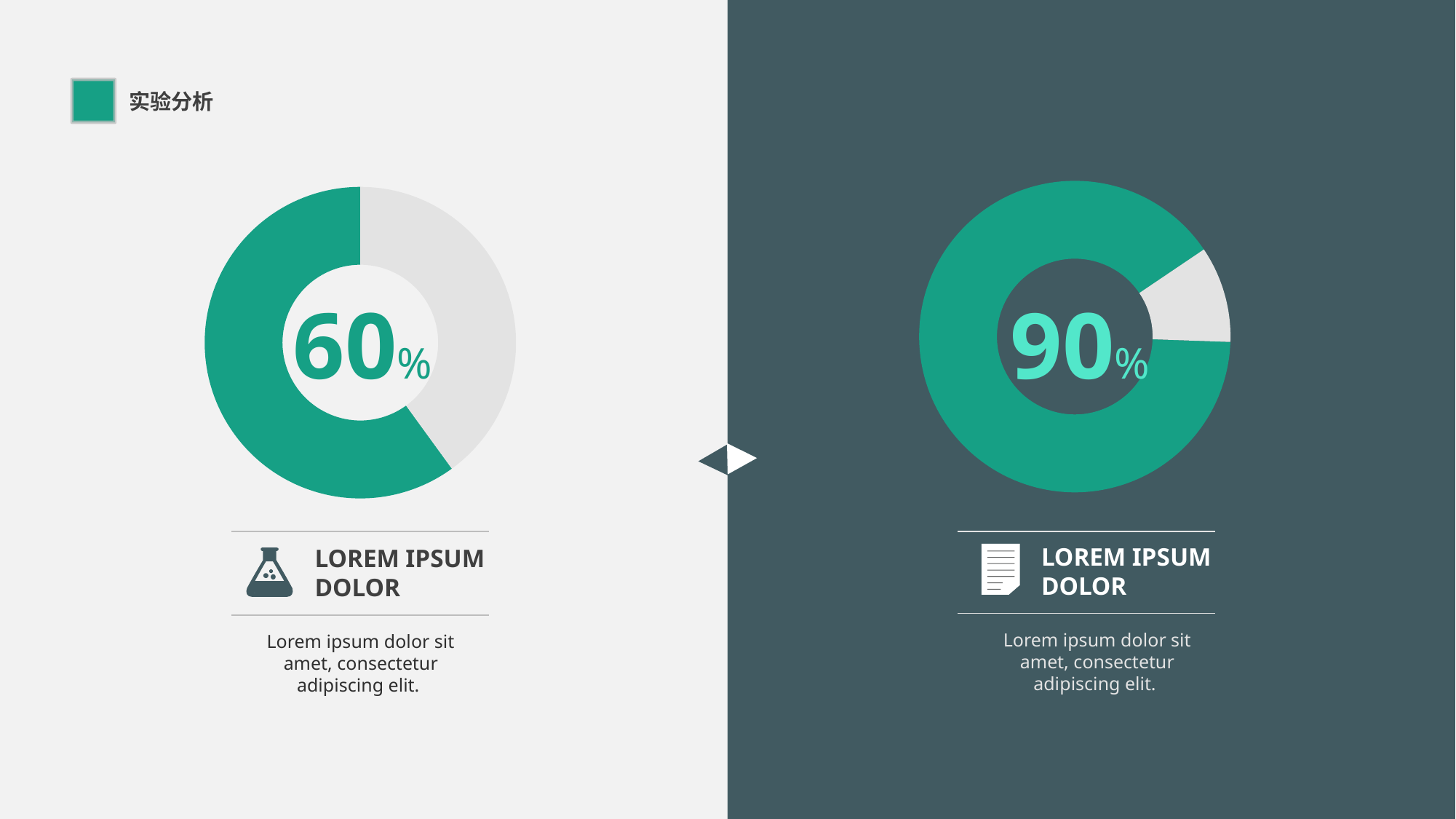
Is the value shown on the left donut chart greater or less than 50%? greater What percentage is shown in the centre of the right donut chart? 90% How many donut charts are on the slide? 2 On the left donut chart, what share of the ring is not filled in green? 40% What is the difference between the percentage on the right chart and the percentage on the left chart? 30% What kind of chart is used on the left side of the slide? donut chart Which chart shows the larger percentage, the left one or the right one? the right one What percentage is shown in the centre of the left donut chart? 60% What is the heading text at the top left of the slide? 实验分析 On the right donut chart, what share of the ring is not filled in green? 10% What colour is the filled portion of the ring in both donut charts? green